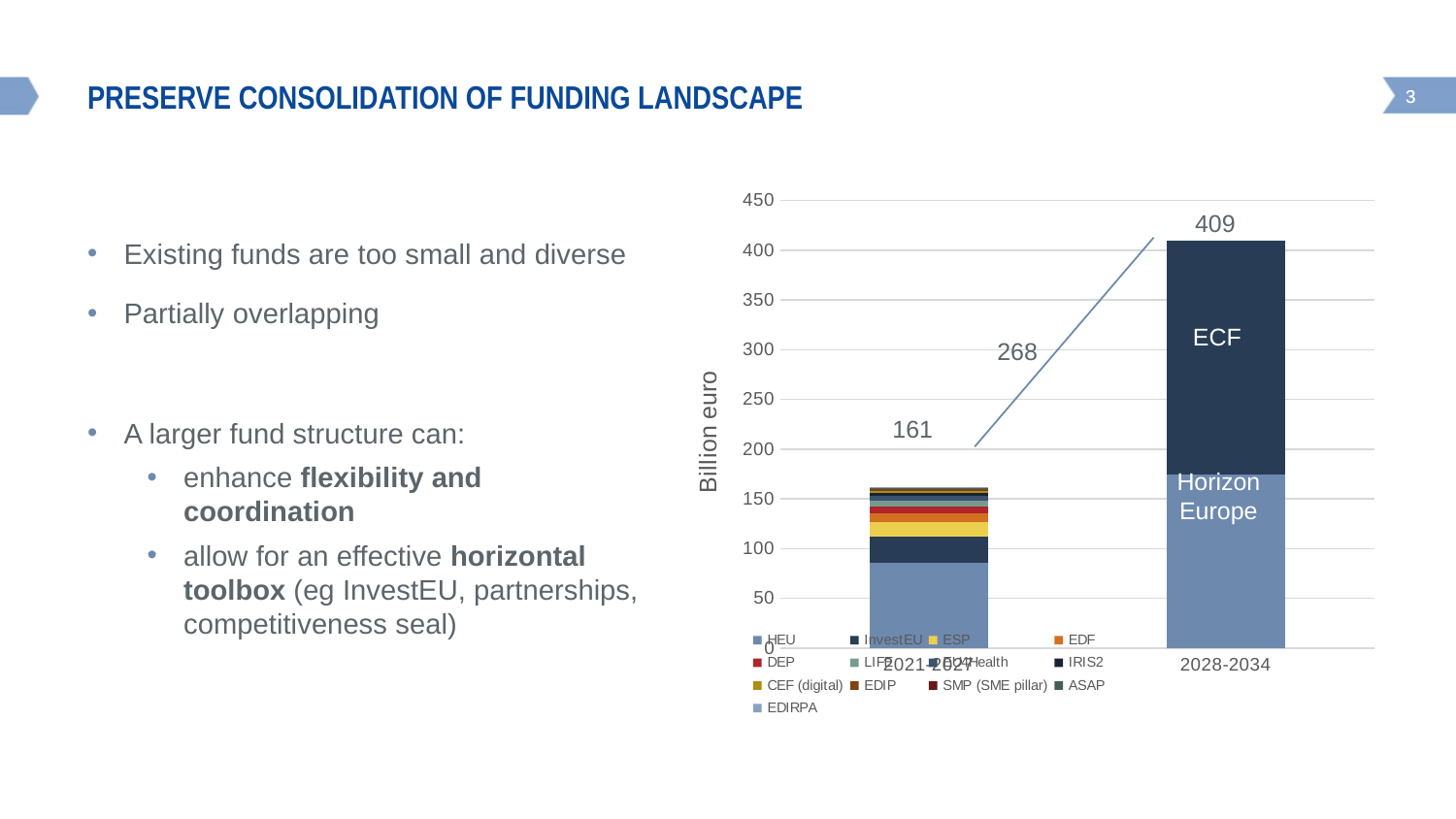
Which period has the larger total, 2021-2027 or 2028-2034? 2028-2034 Which period has the lowest total in the chart? 2021-2027 What kind of chart is shown on the slide? Stacked bar chart Which two segments are labelled inside the 2028-2034 bar? ECF and Horizon Europe What is the total value labelled on the 2028-2034 bar? 409 What is the label on the y axis of the chart? Billion euro Do the totals rise or fall from 2021-2027 to 2028-2034? rise Is the total for 2021-2027 greater or less than 200? less What is the total value labelled on the 2021-2027 bar? 161 Is the Horizon Europe segment of the 2028-2034 bar greater or less than 200? less How many periods (categories) are shown on the x axis of the chart? 2 What is the difference between the 2028-2034 total and the 2021-2027 total? 248